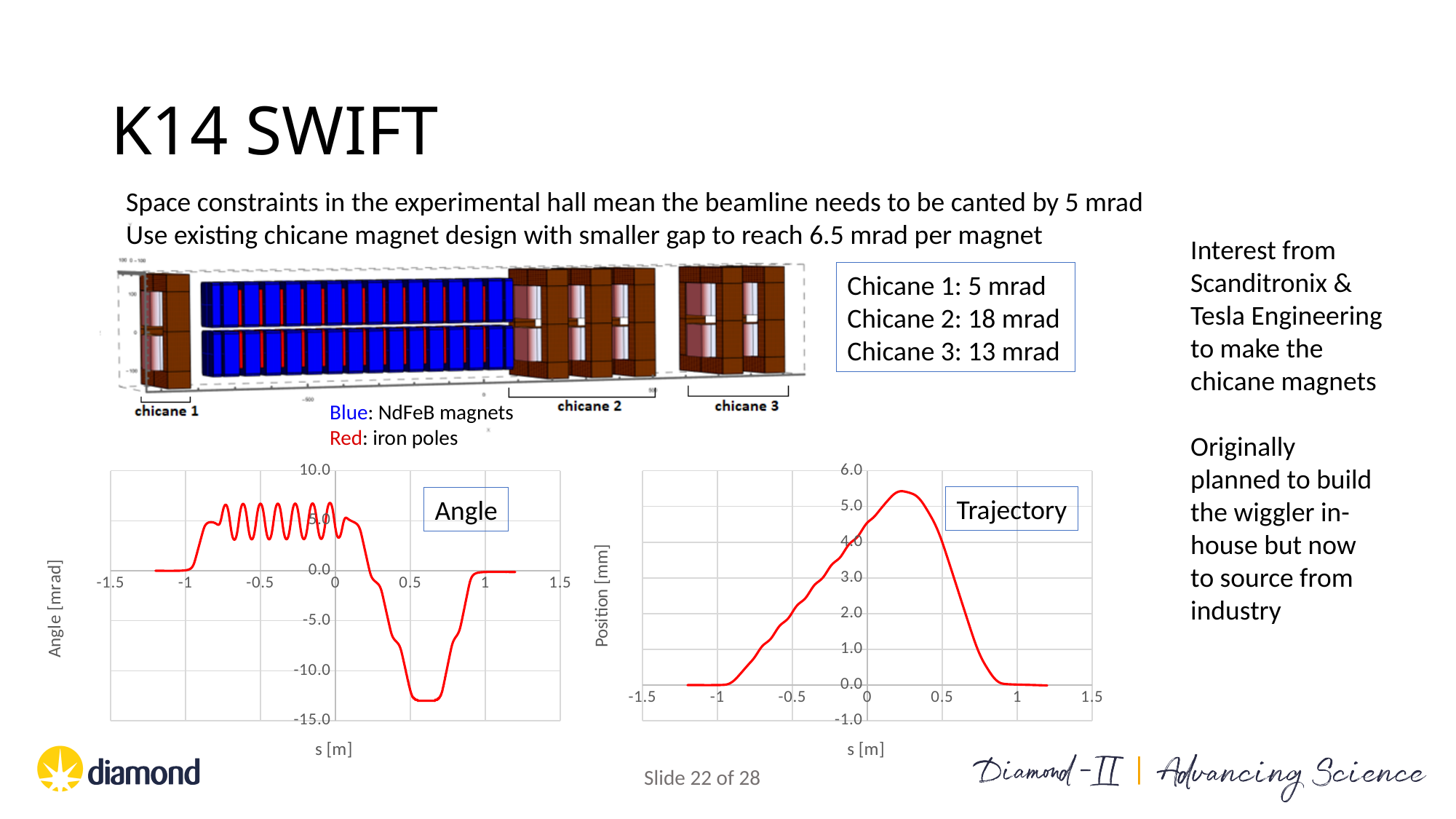
In the Angle chart, is the lowest value of the curve greater or less than -10.0? less What kind of chart is the Trajectory chart? line chart In the Trajectory chart, is the value at s = -0.5 greater or less than 3.0? less What kind of chart is the Angle chart? line chart In the Angle chart, is the value at s = 0.5 greater or less than -5.0? less What is the y-axis label of the Angle chart? Angle [mrad] What is the y-axis label of the Trajectory chart? Position [mm] In the Trajectory chart, does the curve rise or fall between s = -1 and s = 0? rise In the Trajectory chart, does the curve rise or fall between s = 0.5 and s = 1? fall